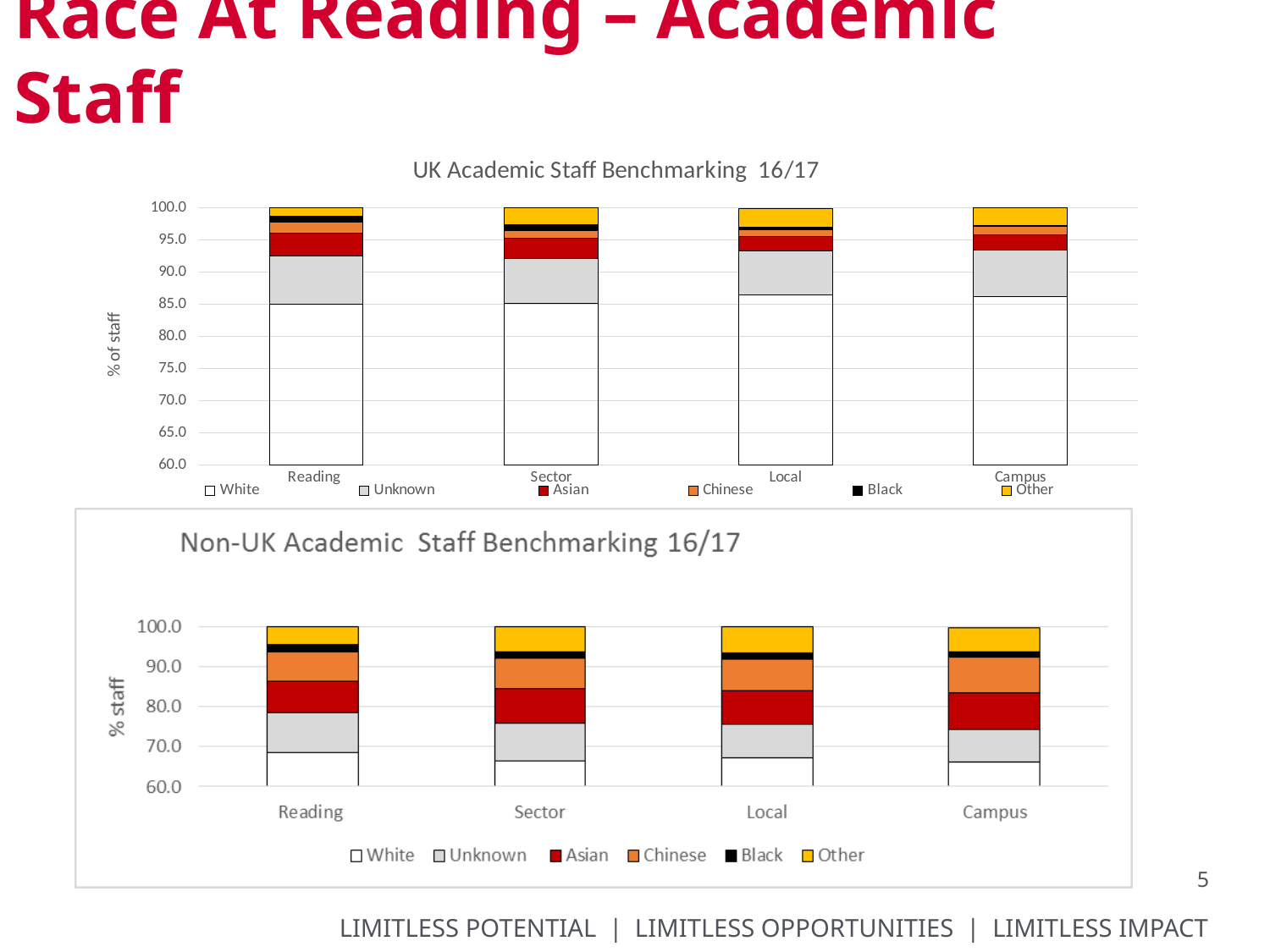
What is the y-axis label of the 'UK Academic Staff Benchmarking 16/17' chart? % of staff In the 'UK Academic Staff Benchmarking 16/17' chart, is the top of the White segment for Local greater or less than 80.0? greater In the 'Non-UK Academic Staff Benchmarking 16/17' chart, is the top of the Asian segment for Sector greater or less than 90.0? less In the 'Non-UK Academic Staff Benchmarking 16/17' chart, is the top of the White segment for Reading greater or less than 70.0? less What type of chart is the 'UK Academic Staff Benchmarking 16/17' chart? stacked bar chart How many categories are shown on the x axis of the 'Non-UK Academic Staff Benchmarking 16/17' chart? 4 Which series is shown in yellow in the legend of the 'Non-UK Academic Staff Benchmarking 16/17' chart? Other How many series does the legend of the 'UK Academic Staff Benchmarking 16/17' chart list? 6 What is the title of the lower chart on the slide? Non-UK Academic Staff Benchmarking 16/17